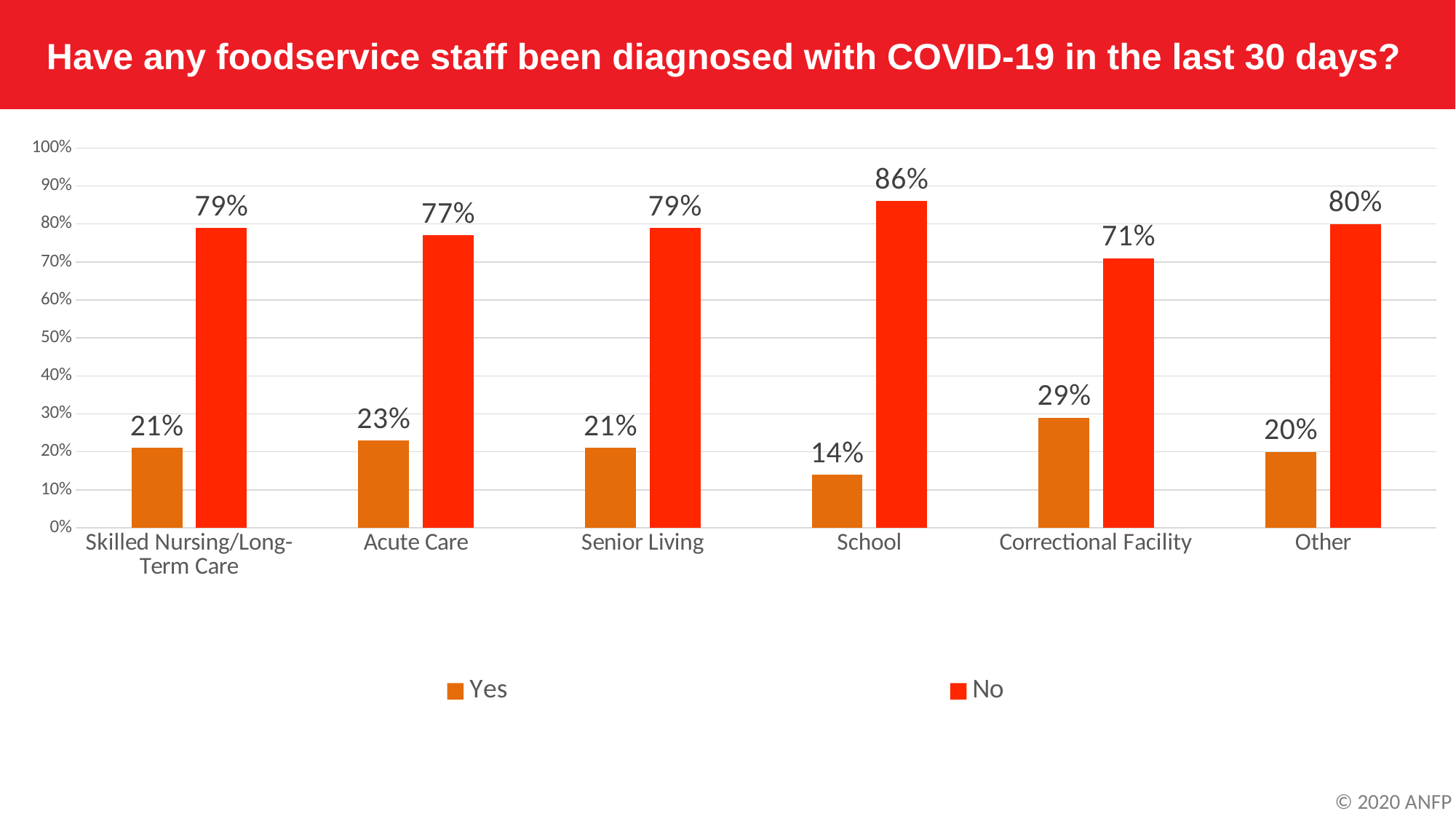
What is the difference between the No and Yes values for Other? 60% What is the No value for Correctional Facility? 71% Which category has the highest No value? School How many categories are shown on the x axis? 6 What percentage of School respondents answered Yes? 14% What is the Yes value for Acute Care? 23% Which is larger, the Yes value for Correctional Facility or the Yes value for Senior Living? Correctional Facility Which category has the lowest Yes value? School What kind of chart is shown on the slide? Bar chart Which colour represents the No series? Red How many series does the legend list? 2 Which category has the highest Yes value? Correctional Facility